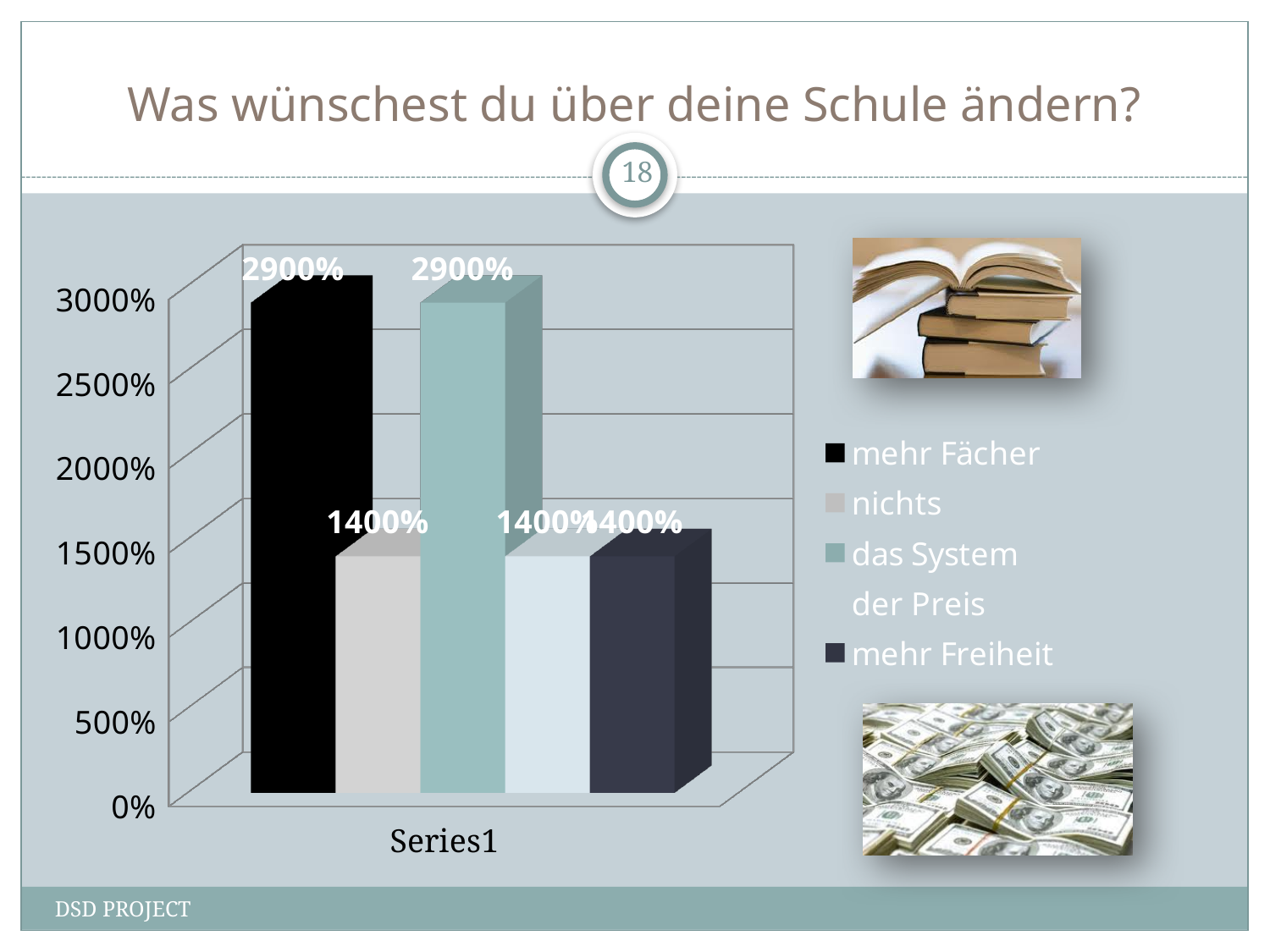
Is the value for "mehr Fächer" greater or less than 2500%? greater Is the value for "der Preis" greater or less than 2000%? less What is the label shown on the horizontal axis of the chart? Series1 What is the value for "mehr Freiheit"? 1400% What is the value for "nichts"? 1400% What is the difference between the values for "mehr Fächer" and "nichts"? 1500% How many bars are plotted in the chart? 5 What is the value for "mehr Fächer"? 2900% Which is larger, the value for "das System" or the value for "der Preis"? das System What kind of chart is shown on the slide? bar chart What is the value for "das System"? 2900% How many entries does the legend list? 5